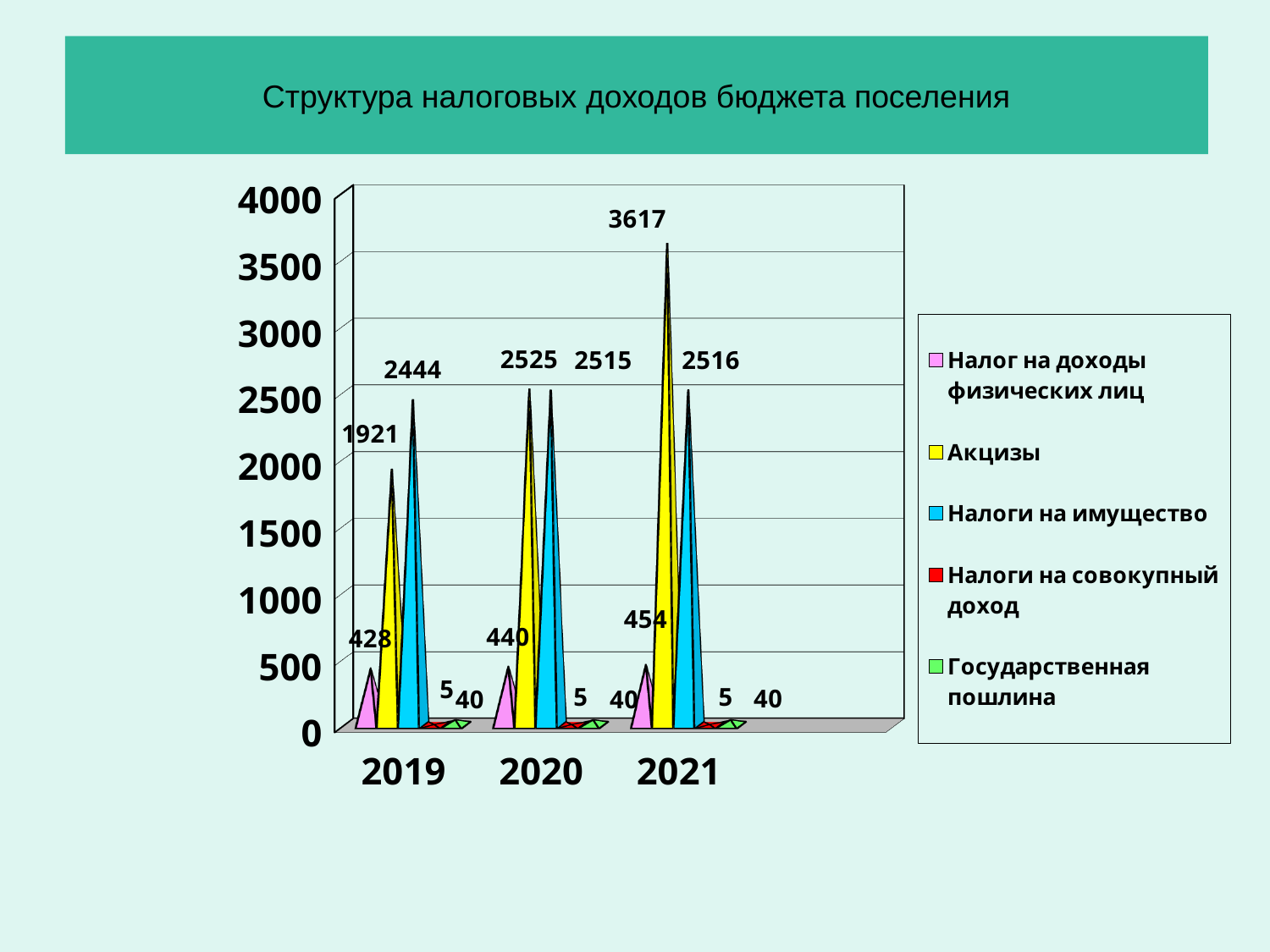
Which series has the lowest value in 2020? Налоги на совокупный доход What is the value of Акцизы for 2021? 3617 How many years are shown on the x axis? 3 How many series does the legend list? 5 What kind of chart is shown on the slide? Bar chart What is the value of Акцизы for 2019? 1921 What is the value of Налоги на имущество for 2020? 2515 What is the value of Налог на доходы физических лиц for 2019? 428 In which year is Акцизы highest? 2021 What is the difference between Акцизы in 2021 and Акцизы in 2020? 1092 Which is larger in 2019: Акцизы or Налоги на имущество? Налоги на имущество Does the value of Налог на доходы физических лиц rise or fall from 2019 to 2021? Rise